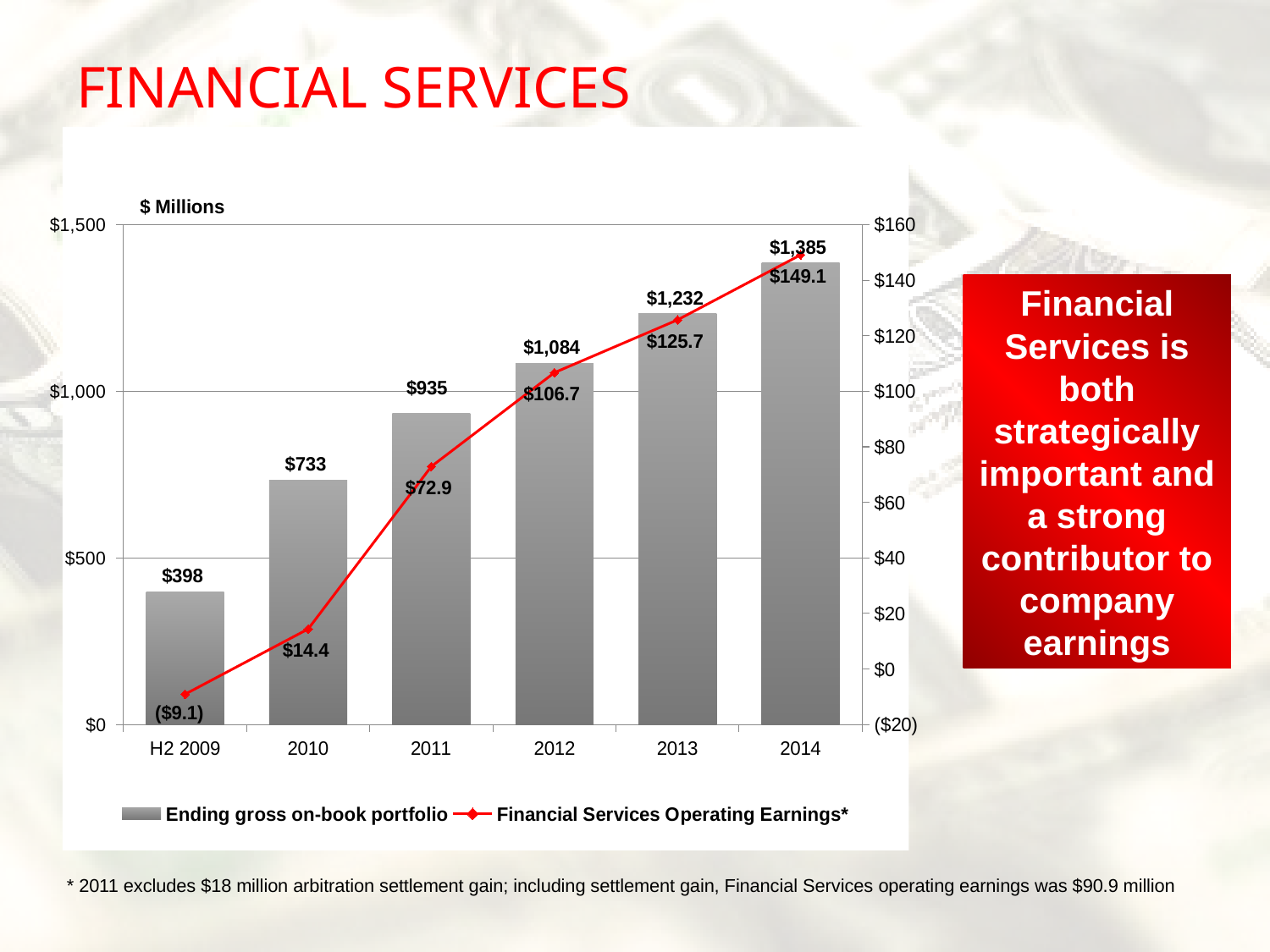
What is the Financial Services Operating Earnings value for 2011? $72.9 What is the difference between the Ending gross on-book portfolio in 2014 and in 2013? $153 What is the Financial Services Operating Earnings value for H2 2009? ($9.1) Which period has the highest Ending gross on-book portfolio? 2014 How many periods are shown on the x axis? 6 What is the Ending gross on-book portfolio value for 2012? $1,084 Do the Financial Services Operating Earnings rise or fall from H2 2009 to 2014? Rise Which is larger, the Ending gross on-book portfolio in 2010 or in 2011? 2011 Which period has the lowest Financial Services Operating Earnings? H2 2009 How many series does the legend list? 2 What unit label is shown above the chart? $ Millions What kind of chart is used to show the Ending gross on-book portfolio? Bar chart